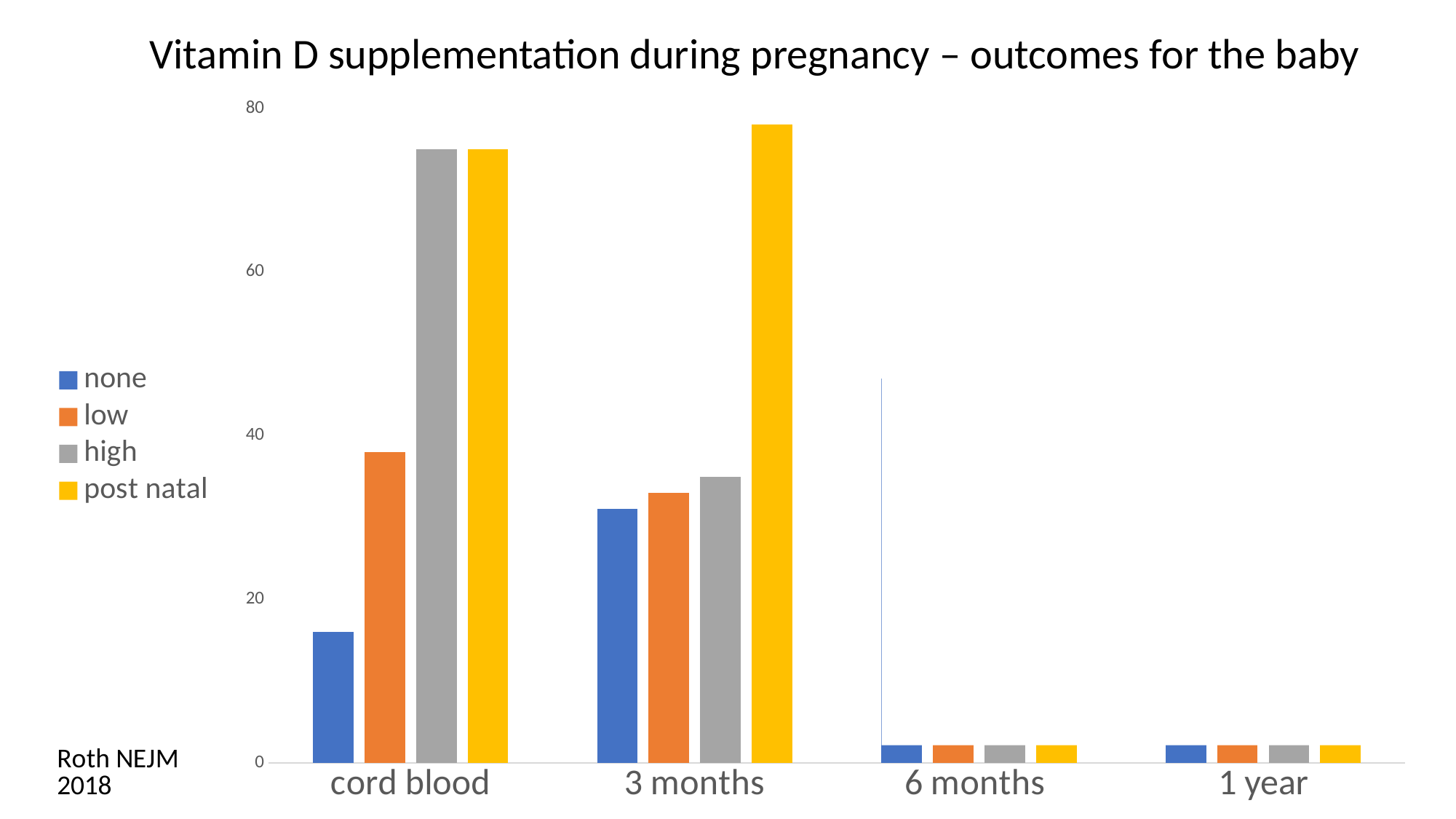
Is the value for 'low' at cord blood greater or less than 40? less Which series has the lowest value at cord blood? none How many series does the legend list? 4 Which is larger at 3 months: the value for 'post natal' or the value for 'none'? post natal What is the title of the chart? Vitamin D supplementation during pregnancy – outcomes for the baby Is the value for 'high' at 3 months greater or less than 40? less Is the value for 'post natal' at 3 months greater or less than 60? greater Which series has the highest value at 3 months? post natal Which is larger at cord blood: the value for 'none' or the value for 'low'? low How many categories are shown along the x axis? 4 What kind of chart is shown on the slide? bar chart